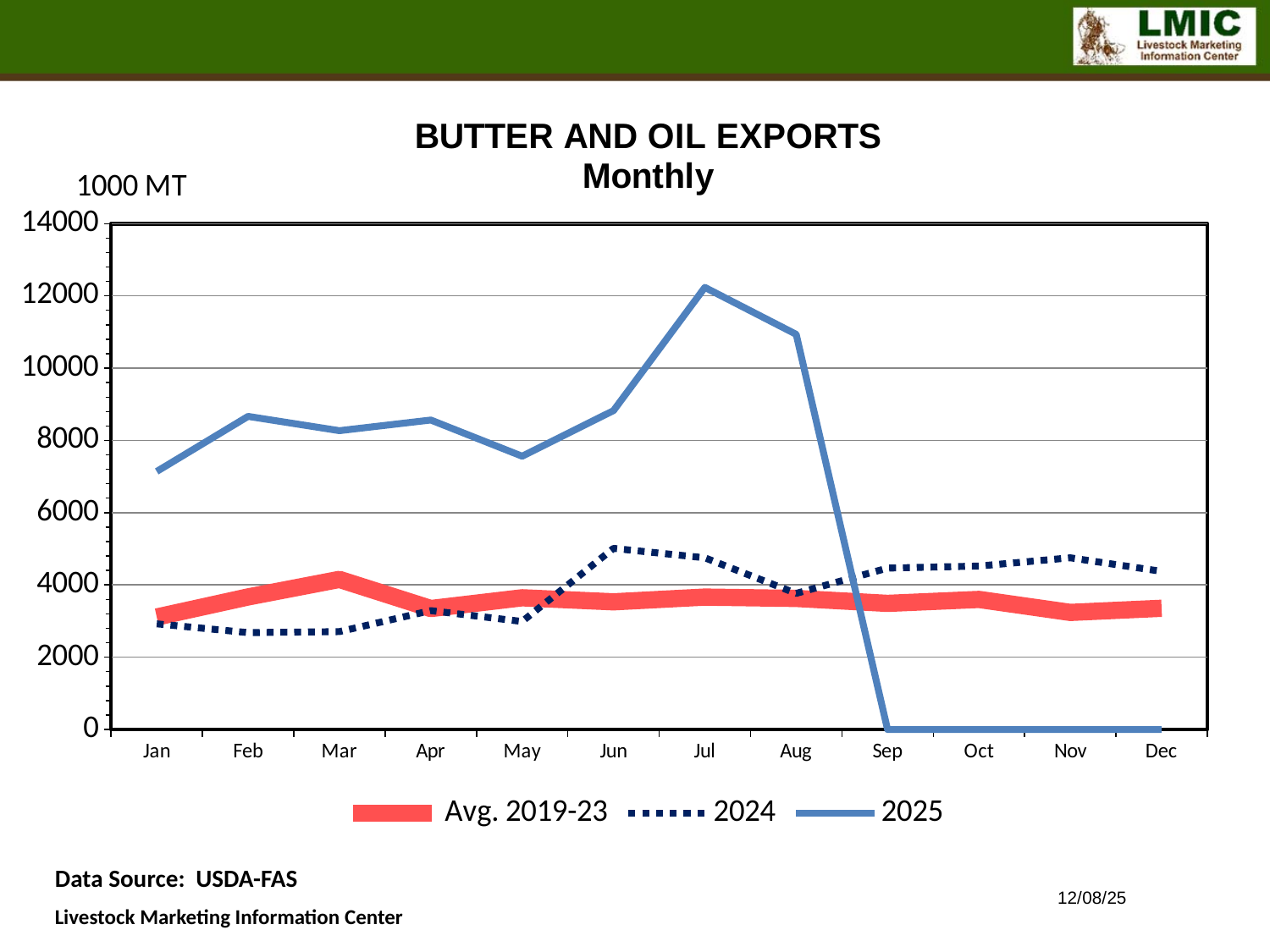
What kind of chart is shown on the slide? line chart Is the value for 2025 in Jan greater or less than 8000? less Which series has the larger value in Jul, 2025 or 2024? 2025 What unit is shown on the y axis of the chart? 1000 MT How many months are shown along the x axis? 12 Is the value for 2025 in Jul greater or less than 10000? greater Is the value for 2024 in Feb greater or less than 4000? less Which series has the larger value in Nov, 2024 or Avg. 2019-23? 2024 In which month does the 2025 series reach its highest value? Jul Does the 2025 series rise or fall from Jun to Jul? rise How many series does the legend list? 3